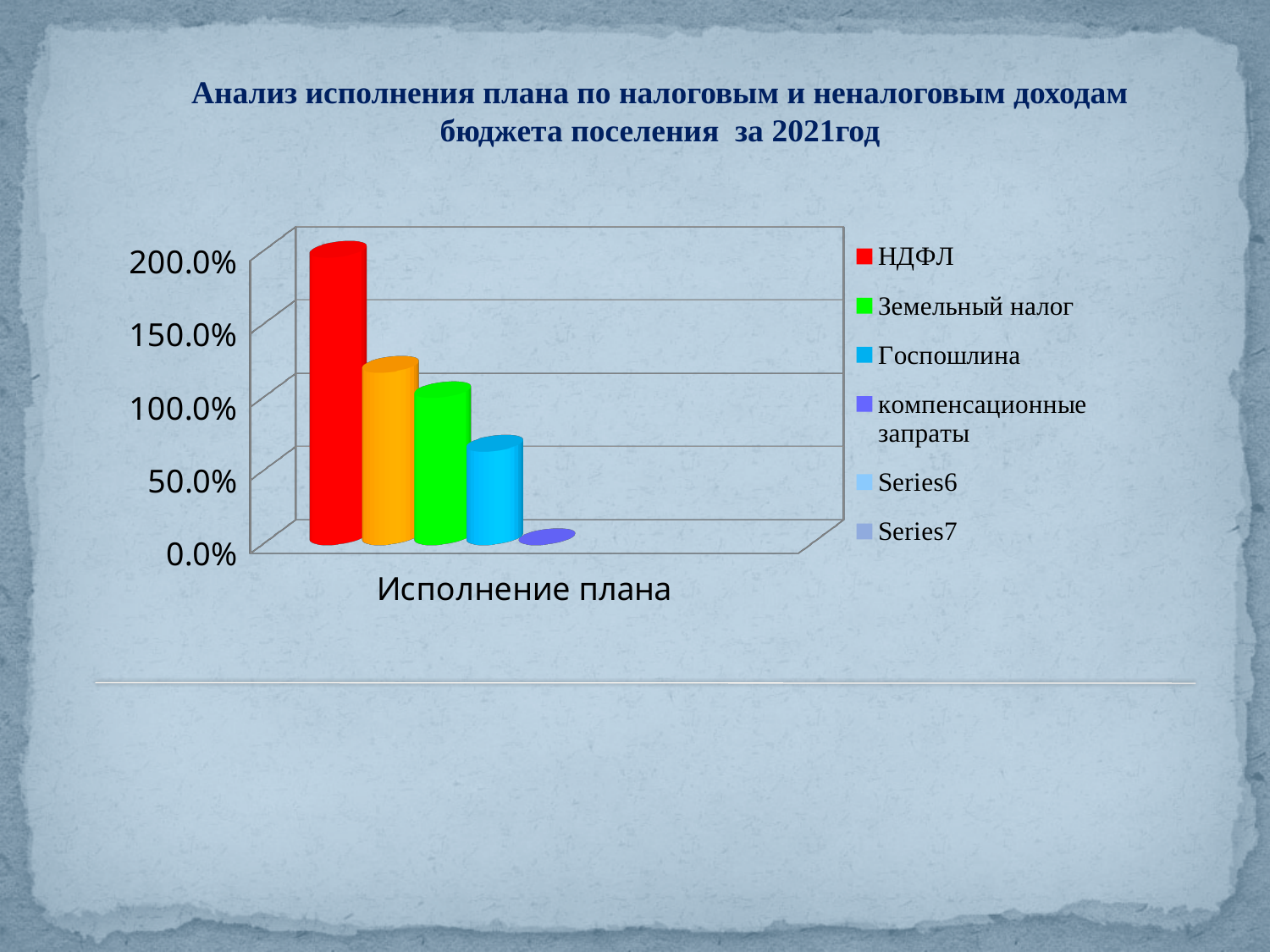
Is the value for НДФЛ greater or less than 150.0%? greater Is the value for Госпошлина greater or less than 50.0%? greater How many categories are shown on the x axis? 1 Which series has the lowest bar? компенсационные запраты Which is larger, the value for НДФЛ or the value for Госпошлина? НДФЛ Is the value for Земельный налог greater or less than 150.0%? less What is the category label on the x axis? Исполнение плана What kind of chart is shown on the slide? bar chart Which series has the highest bar? НДФЛ How many series does the legend list? 6 Which colour represents НДФЛ in the legend? red